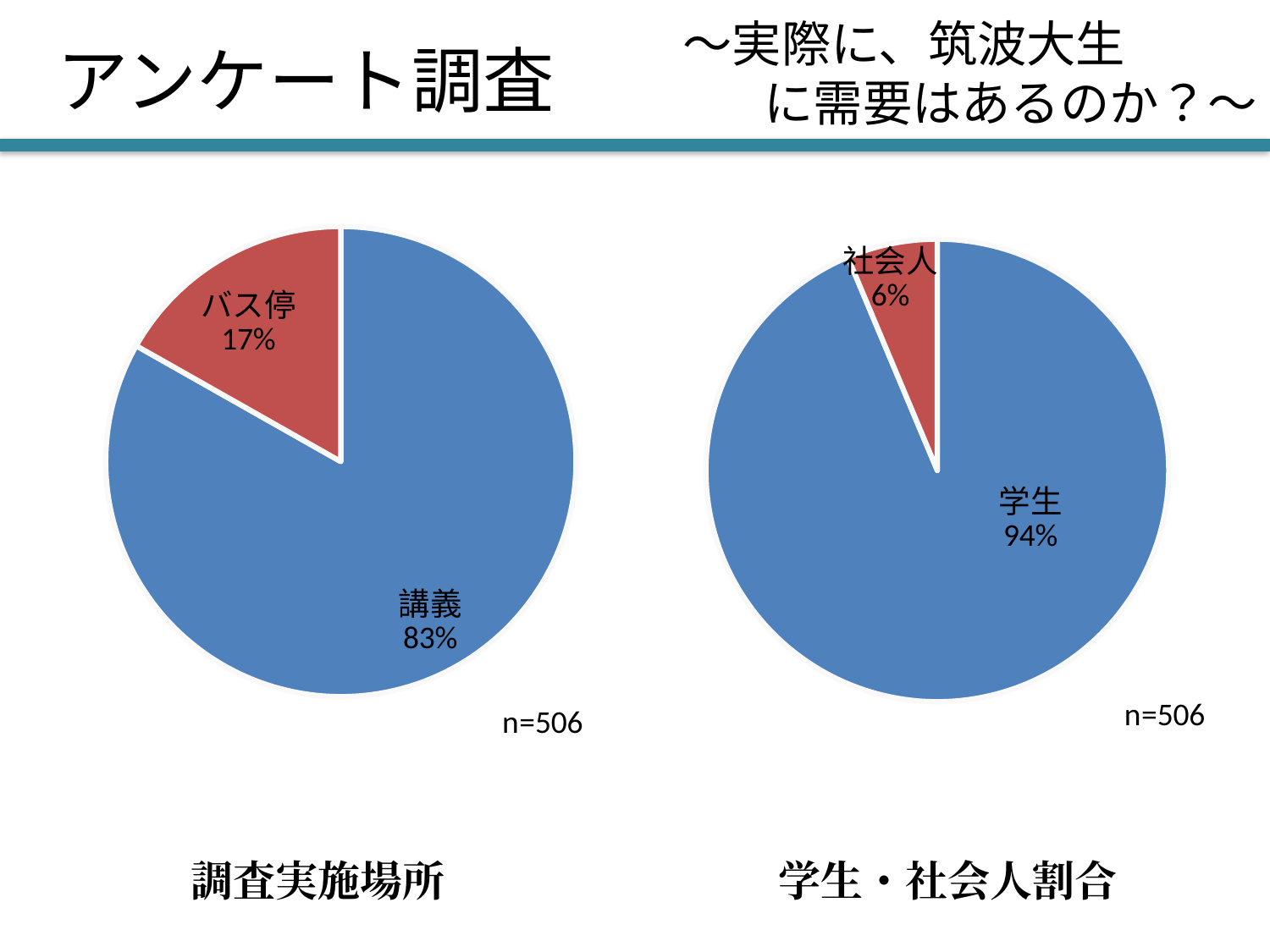
In the left pie chart (調査実施場所), which slice is the largest? 講義 In the left pie chart (調査実施場所), what is the difference in percentage points between 講義 and バス停? 66 How many slices does the left pie chart (調査実施場所) have? 2 In the right pie chart (学生・社会人割合), what share is labelled for 学生? 94% In the right pie chart (学生・社会人割合), which is larger, 学生 or 社会人? 学生 What sample size (n) is shown below the left pie chart (調査実施場所)? n=506 In the right pie chart (学生・社会人割合), what share is labelled for 社会人? 6% What type of chart is the right chart (学生・社会人割合)? Pie chart In the left pie chart (調査実施場所), what share is labelled for 講義? 83% In the right pie chart (学生・社会人割合), what is the difference in percentage points between 学生 and 社会人? 88 In the right pie chart (学生・社会人割合), which slice is the smallest? 社会人